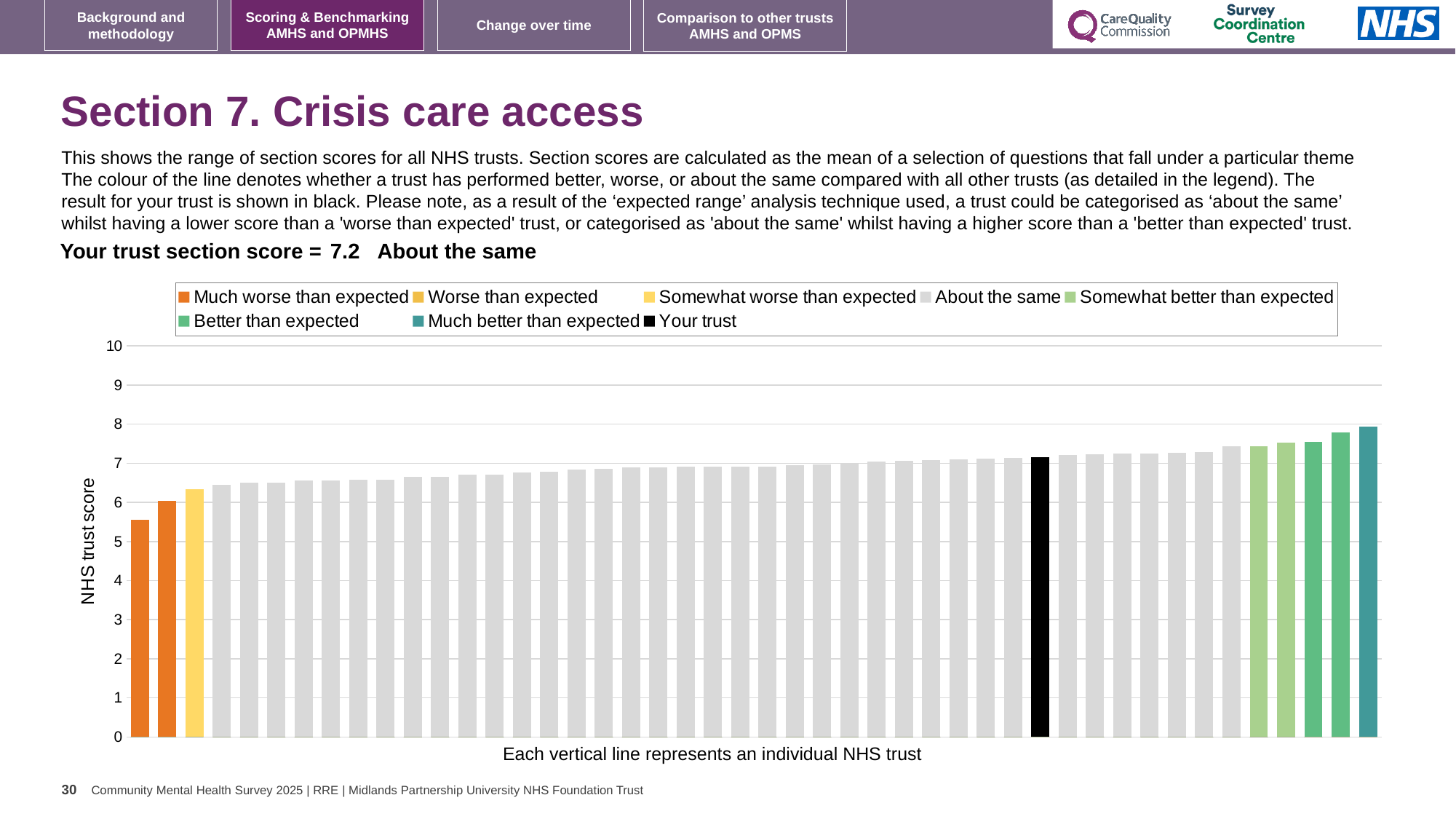
How many bars are coloured as 'Much worse than expected'? 2 Is the value of the leftmost bar greater or less than 6? less What is the section score for your trust shown on the slide? 7.2 What is the label on the vertical axis of the chart? NHS trust score Do the bar values rise or fall from left to right across the chart? rise What kind of chart is shown on the slide? bar chart How many bars are coloured as 'Much better than expected'? 1 Is the value of the black 'Your trust' bar greater or less than 7? greater Which legend category does the tallest bar belong to? Much better than expected Is the value of the leftmost bar greater or less than 5? greater How many entries does the chart legend list? 8